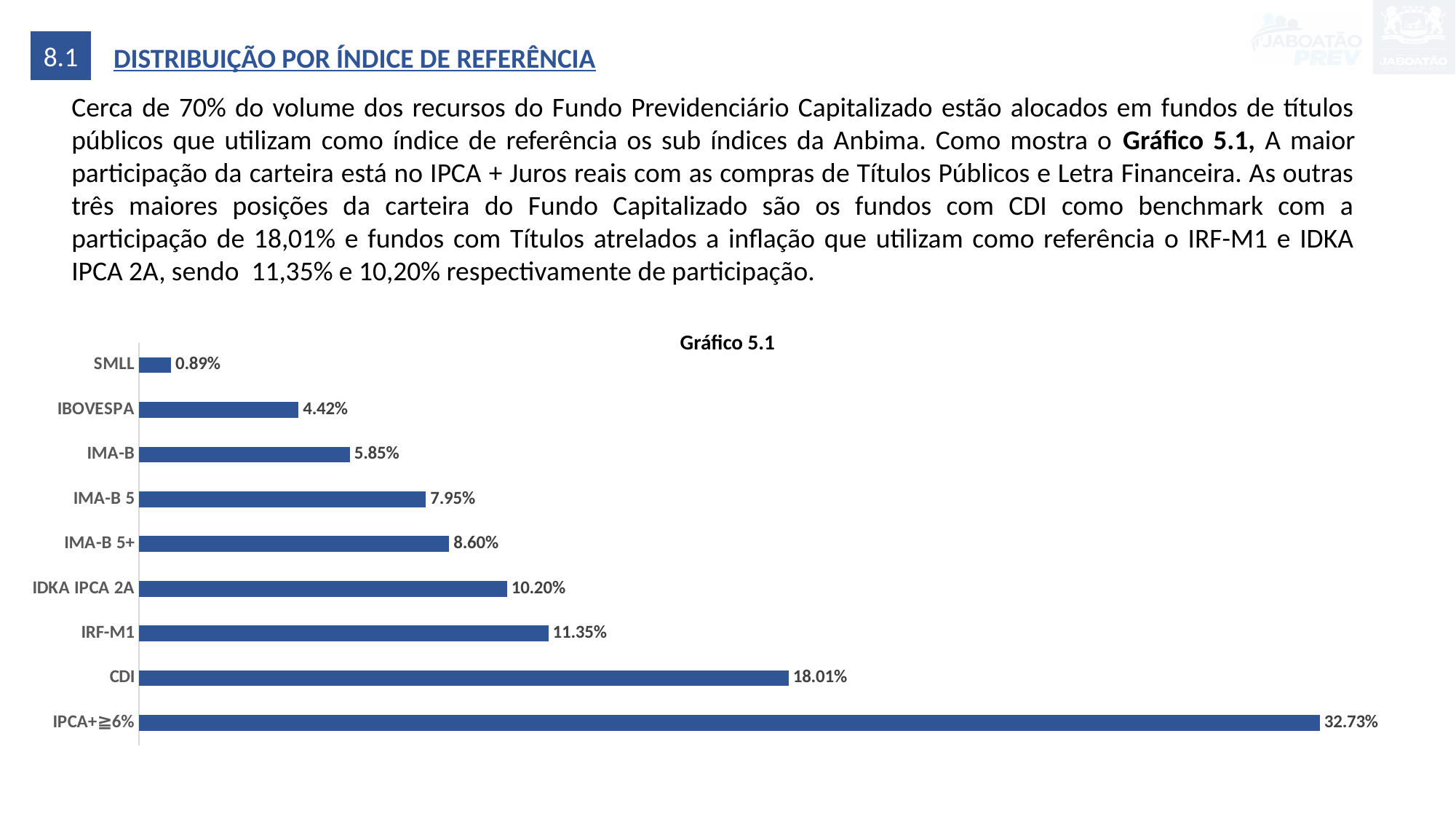
What is the value for SMLL in Gráfico 5.1? 0.89% What is the title of the chart on the slide? Gráfico 5.1 Which category has the lowest value in Gráfico 5.1? SMLL What is the difference between the values for CDI and IRF-M1 in Gráfico 5.1? 6.66% Which is larger in Gráfico 5.1, IDKA IPCA 2A or IBOVESPA? IDKA IPCA 2A What kind of chart is Gráfico 5.1? Bar chart What is the difference between the values for IMA-B 5 and IMA-B in Gráfico 5.1? 2.10% What is the value for IMA-B 5+ in Gráfico 5.1? 8.60% How many categories are shown in Gráfico 5.1? 9 What is the value for CDI in Gráfico 5.1? 18.01% Which category has the highest value in Gráfico 5.1? IPCA+≧6% What is the value for IRF-M1 in Gráfico 5.1? 11.35%